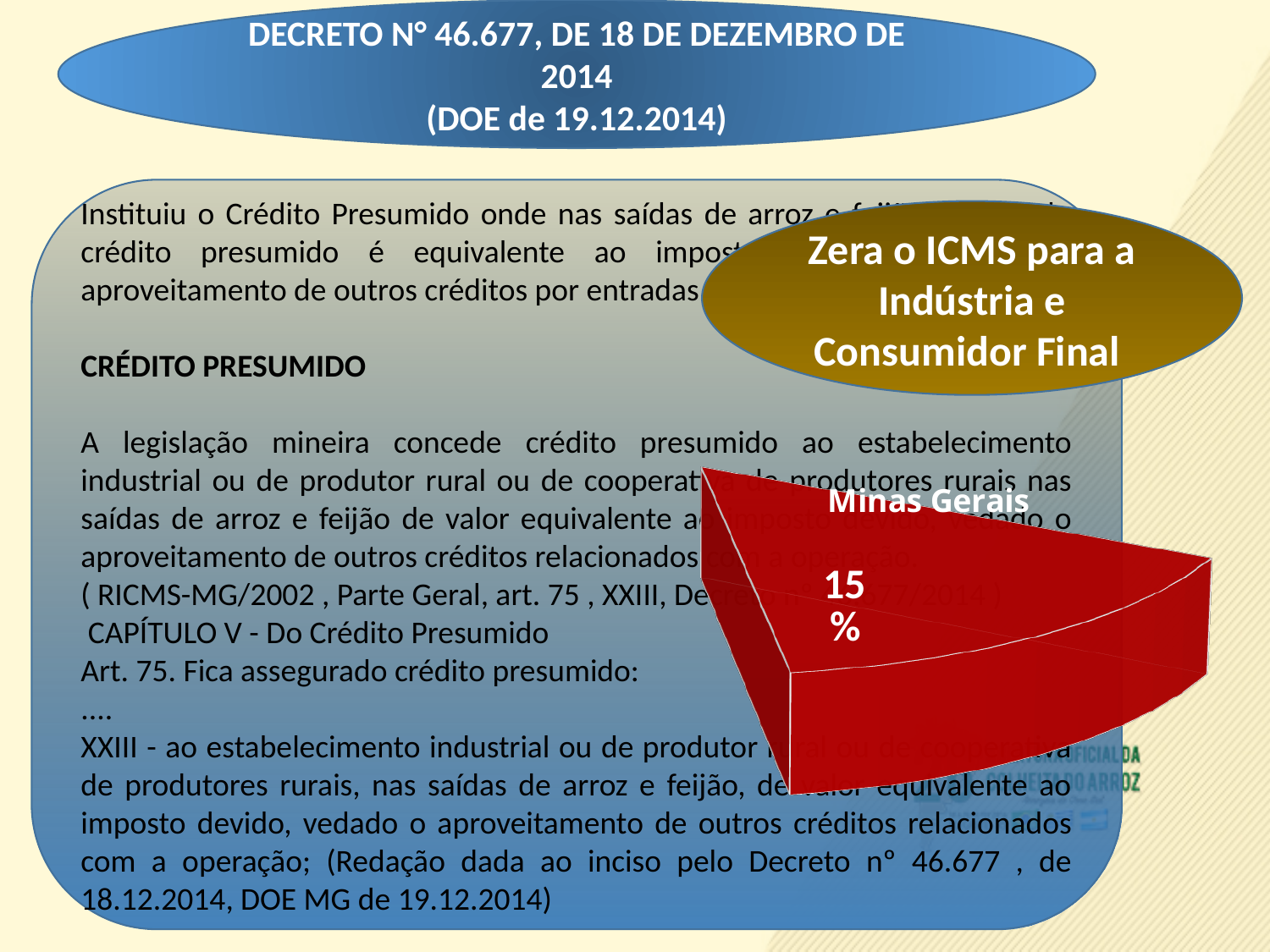
What kind of chart is shown on the slide? pie chart What colour is the slice shown in the pie chart? red What percentage is printed on the red slice of the pie chart? 15% Is the value shown on the pie chart slice greater or less than 10%? greater Is the value shown on the pie chart slice greater or less than 20%? less What is the title of the pie chart? Minas Gerais